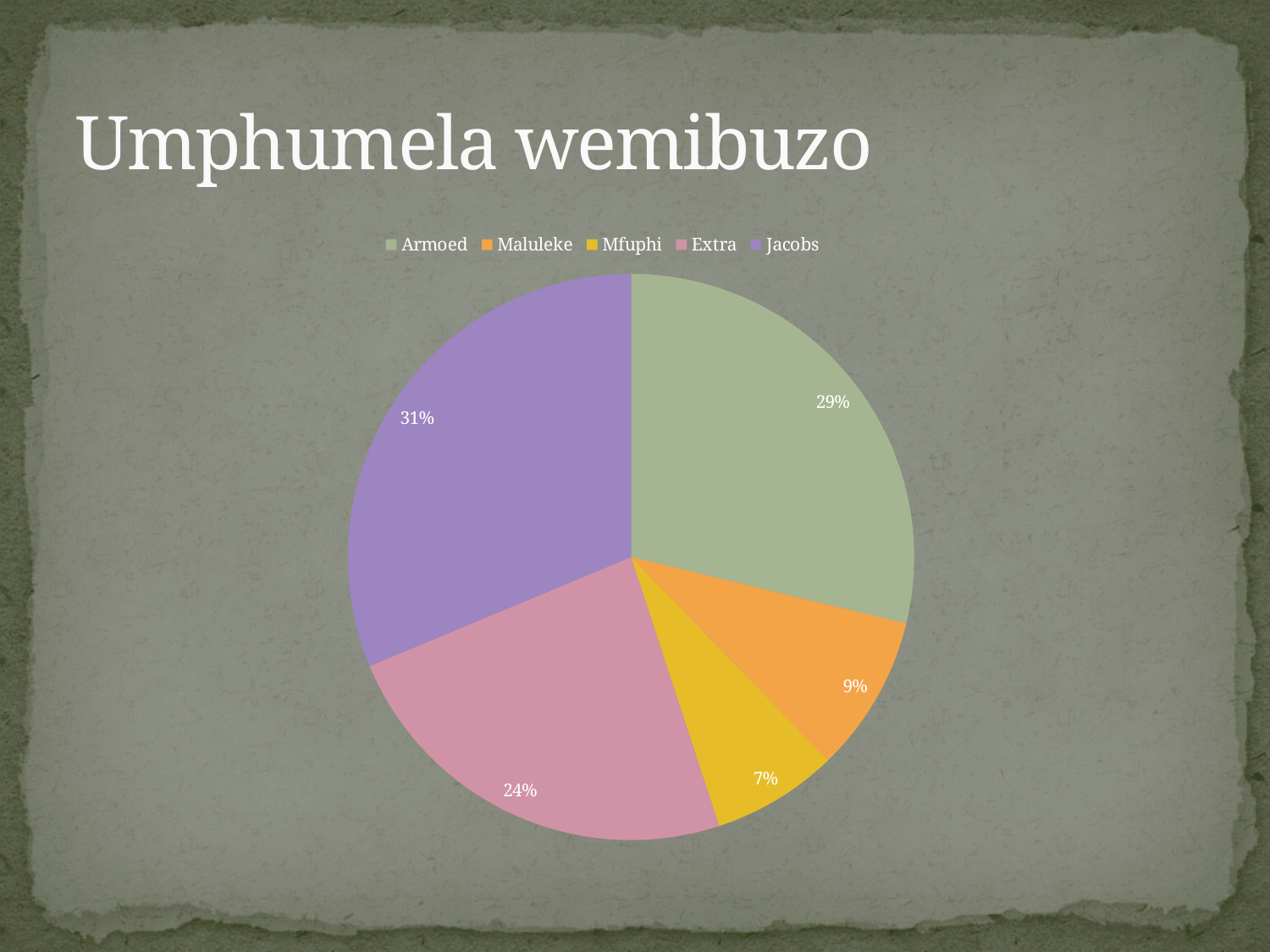
What kind of chart is shown on the slide? Pie chart What share of the pie does Mfuphi have? 7% How many categories are shown in the pie chart? 5 What share of the pie does Armoed have? 29% What share of the pie does Extra have? 24% What is the difference in percentage points between Jacobs and Extra? 7 Which category has the smallest slice of the pie? Mfuphi Which category has the largest slice of the pie? Jacobs What is the title of the slide containing the chart? Umphumela wemibuzo Which is larger, the share for Armoed or the share for Extra? Armoed